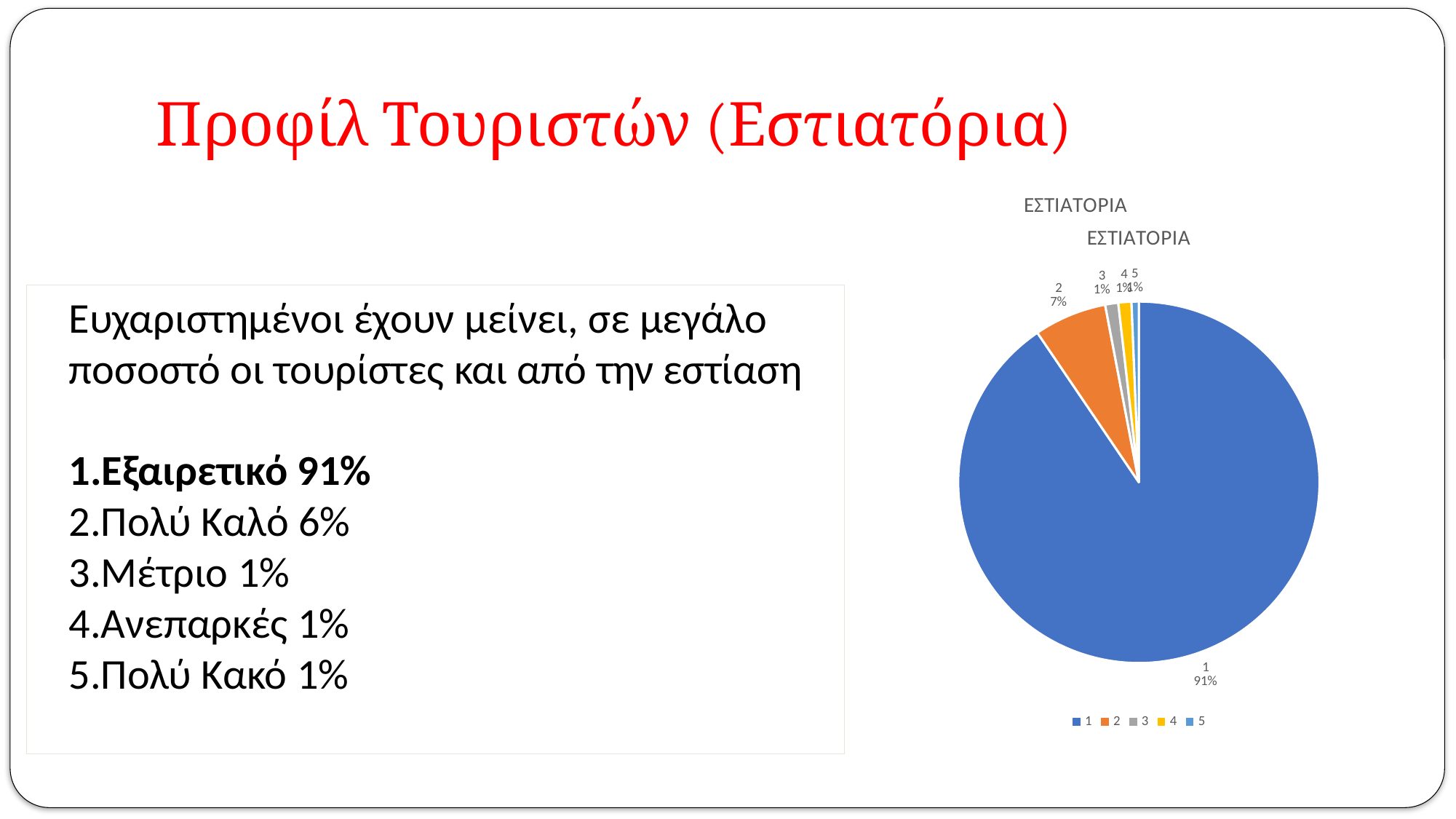
What is the title of the chart? ΕΣΤΙΑΤΟΡΙΑ What percentage does slice 3 represent in the pie chart? 1% What kind of chart is shown on the slide? pie chart What percentage does slice 1 represent in the pie chart? 91% What is the difference between the percentages of slice 1 and slice 2 in the pie chart? 84% What colour is slice 1 in the pie chart? blue What percentage does slice 2 represent in the pie chart? 7% How many slices does the pie chart have? 5 Which category has the largest slice in the pie chart? 1 Which is larger in the pie chart, slice 2 or slice 3? 2 How many entries does the legend of the pie chart list? 5 What share of the pie does slice 4 represent? 1%